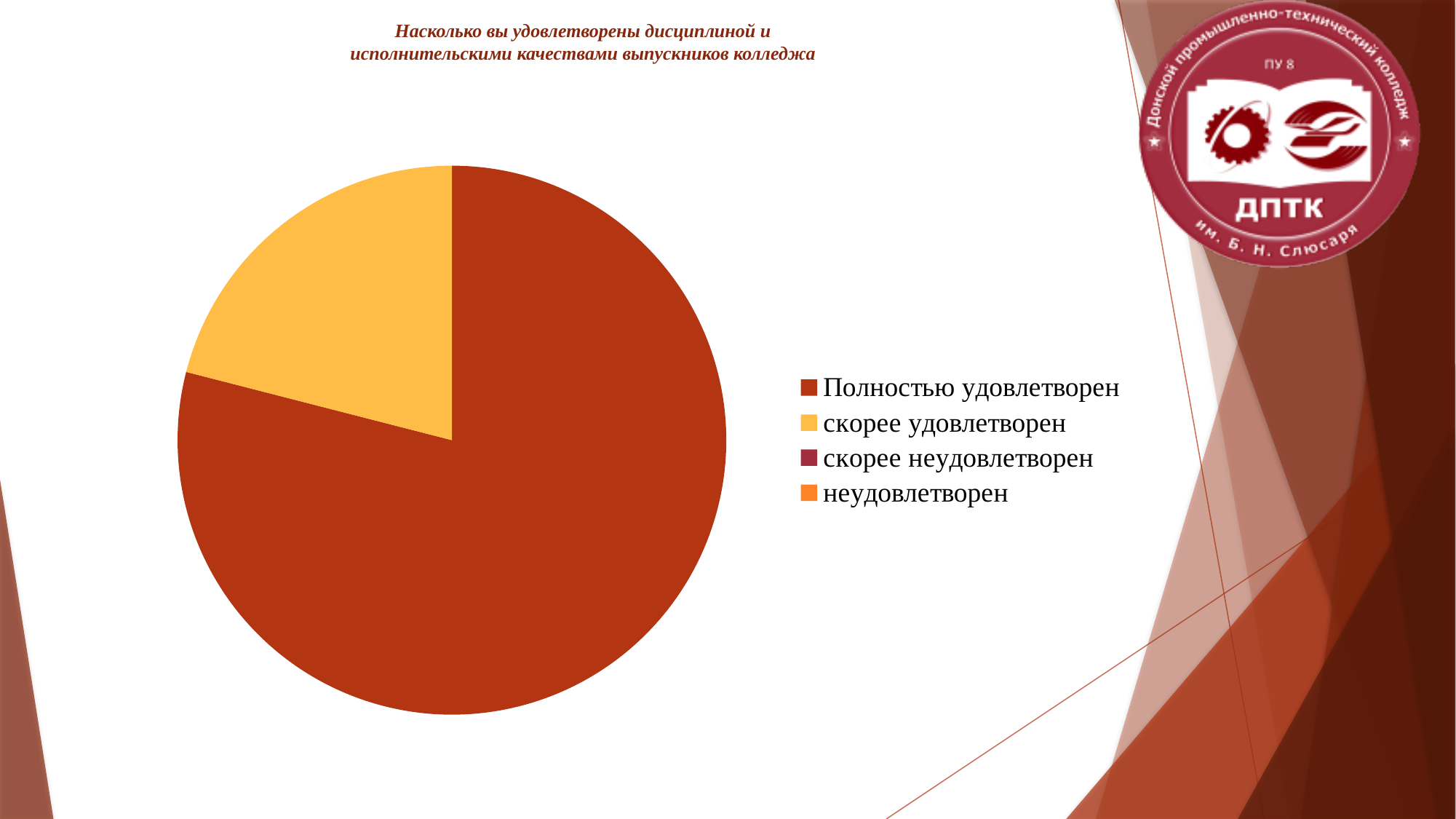
What kind of chart is shown on the slide? pie chart Which category has the largest slice of the pie? Полностью удовлетворен Does the slice for Полностью удовлетворен take up more or less than half of the pie? more What colour is the slice for скорее удовлетворен? yellow Which slice is larger: Полностью удовлетворен or скорее удовлетворен? Полностью удовлетворен How many entries does the chart legend list? 4 How many slices are visible in the pie? 2 What is the title of the chart? Насколько вы удовлетворены дисциплиной и исполнительскими качествами выпускников колледжа